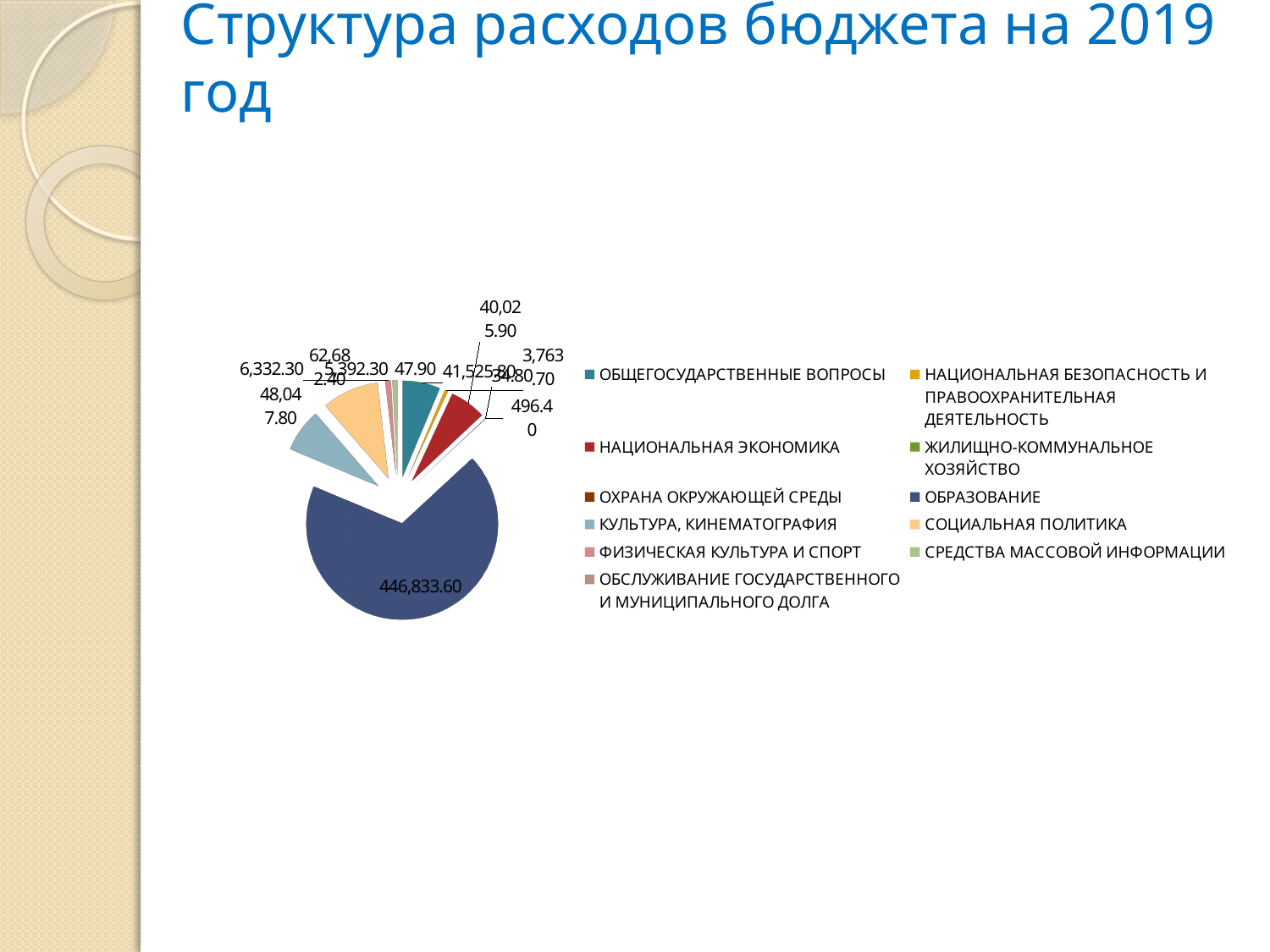
What colour is the ОБРАЗОВАНИЕ slice in the pie chart? dark blue Which slice is larger in the pie chart: ОБРАЗОВАНИЕ or КУЛЬТУРА, КИНЕМАТОГРАФИЯ? ОБРАЗОВАНИЕ What is the title of the slide containing the pie chart? Структура расходов бюджета на 2019 год Which category has the largest slice in the pie chart? ОБРАЗОВАНИЕ Which slice is larger in the pie chart: ОБРАЗОВАНИЕ or СОЦИАЛЬНАЯ ПОЛИТИКА? ОБРАЗОВАНИЕ What value is labelled on the largest slice of the pie chart (ОБРАЗОВАНИЕ)? 446,833.60 How many categories does the legend of the pie chart list? 11 Which slice is larger in the pie chart: ОБРАЗОВАНИЕ or НАЦИОНАЛЬНАЯ ЭКОНОМИКА? ОБРАЗОВАНИЕ What kind of chart is shown on the slide? pie chart